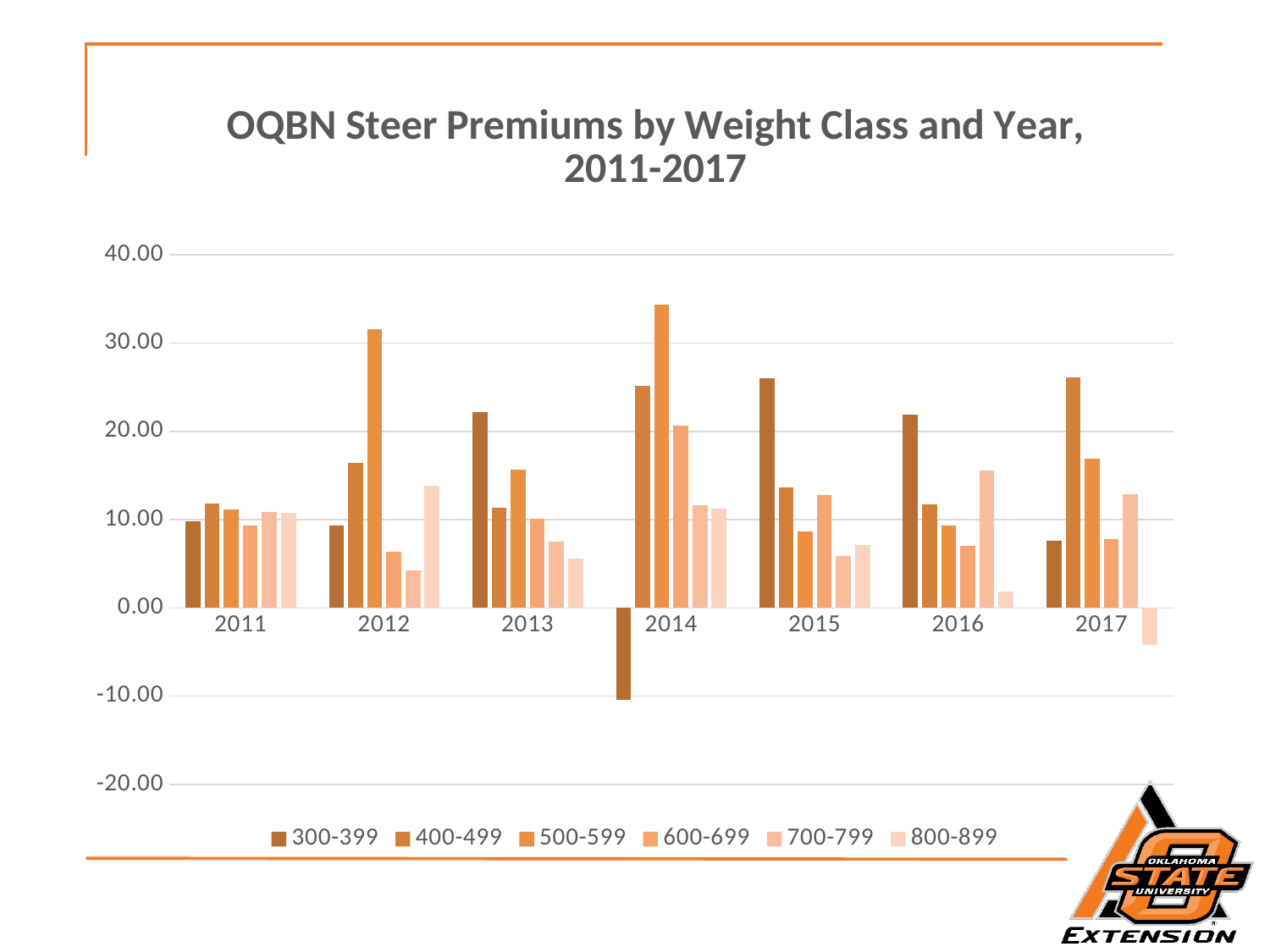
In 2015, which is larger: the 300-399 bar or the 400-499 bar? 300-399 Is the value for 500-599 in 2012 greater or less than 30.00? greater Is the value for 300-399 in 2014 greater or less than 0.00? less Is the value for 800-899 in 2017 greater or less than 0.00? less In which year is the 500-599 bar the highest? 2014 What is the title of the chart? OQBN Steer Premiums by Weight Class and Year, 2011-2017 How many weight-class series does the legend list? 6 In 2017, which is larger: the 400-499 bar or the 500-599 bar? 400-499 How many years are shown along the x axis? 7 Which bar is the lowest on the whole chart? 300-399 in 2014 What kind of chart is shown on the slide? Bar chart